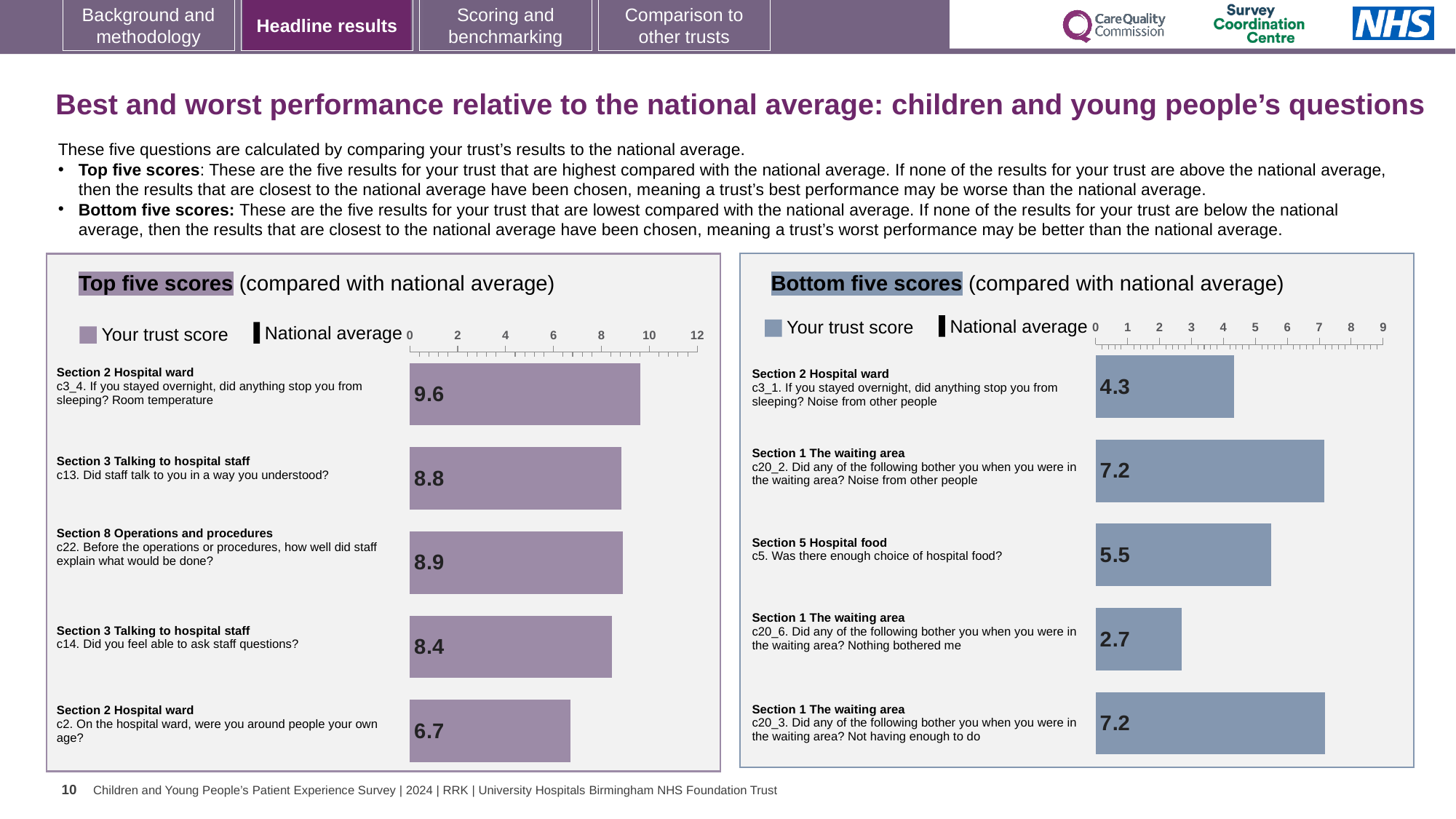
How many series does the legend of the Top five scores chart list? 2 In the Bottom five scores chart, which question has the lowest trust score? c20_6. Did any of the following bother you when you were in the waiting area? Nothing bothered me In the Bottom five scores chart, which has the larger trust score: c3_1 (noise from other people on the ward) or c5 (choice of hospital food)? c5 (5.5) In the Bottom five scores chart, what is the difference between the trust scores for c20_2 (7.2) and c3_1 (4.3)? 2.9 In the Bottom five scores chart, what is the trust score for c20_6 (nothing bothered me in the waiting area)? 2.7 In the Top five scores chart, what is the trust score for c14 (did you feel able to ask staff questions)? 8.4 In the Top five scores chart, what is the difference between the trust scores for c3_4 (9.6) and c2 (6.7)? 2.9 In the Bottom five scores chart, what is the trust score for c5 (was there enough choice of hospital food)? 5.5 How many questions are shown in the Bottom five scores chart? 5 In the Top five scores chart, what is the trust score for c3_4 (did anything stop you from sleeping? Room temperature)? 9.6 In the Top five scores chart, which question has the highest trust score? c3_4. If you stayed overnight, did anything stop you from sleeping? Room temperature In the Top five scores chart, which question has the lowest trust score? c2. On the hospital ward, were you around people your own age?